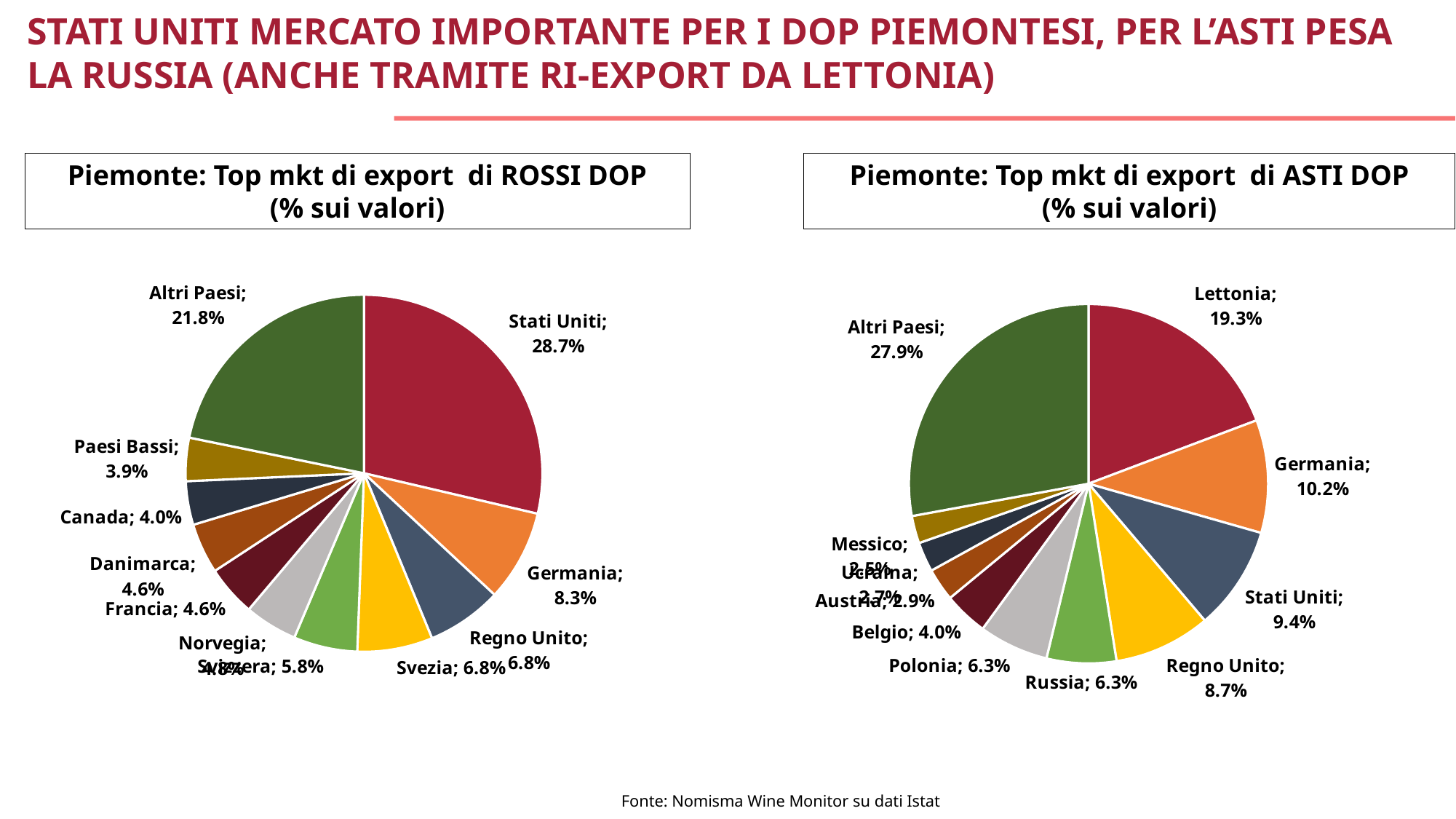
In the ASTI DOP pie chart, what is the share for Regno Unito? 8.7% In the ROSSI DOP pie chart, which is larger, Svizzera or Canada? Svizzera In the ROSSI DOP pie chart, which slice is the largest? Stati Uniti In the ROSSI DOP pie chart, what is the difference between the Stati Uniti share and the Altri Paesi share? 6.9 percentage points In the ASTI DOP pie chart, which is larger, Belgio or Polonia? Polonia In the ROSSI DOP pie chart, what share does Stati Uniti have? 28.7% In the ROSSI DOP pie chart, what is the share for Germania? 8.3% What type of chart is used on this slide? Pie chart In the ASTI DOP pie chart, what share does Lettonia have? 19.3% How many slices does the ASTI DOP pie chart have? 11 In the ASTI DOP pie chart, what is the difference between the Germania share and the Stati Uniti share? 0.8 percentage points In the ASTI DOP pie chart, which slice is the largest? Altri Paesi